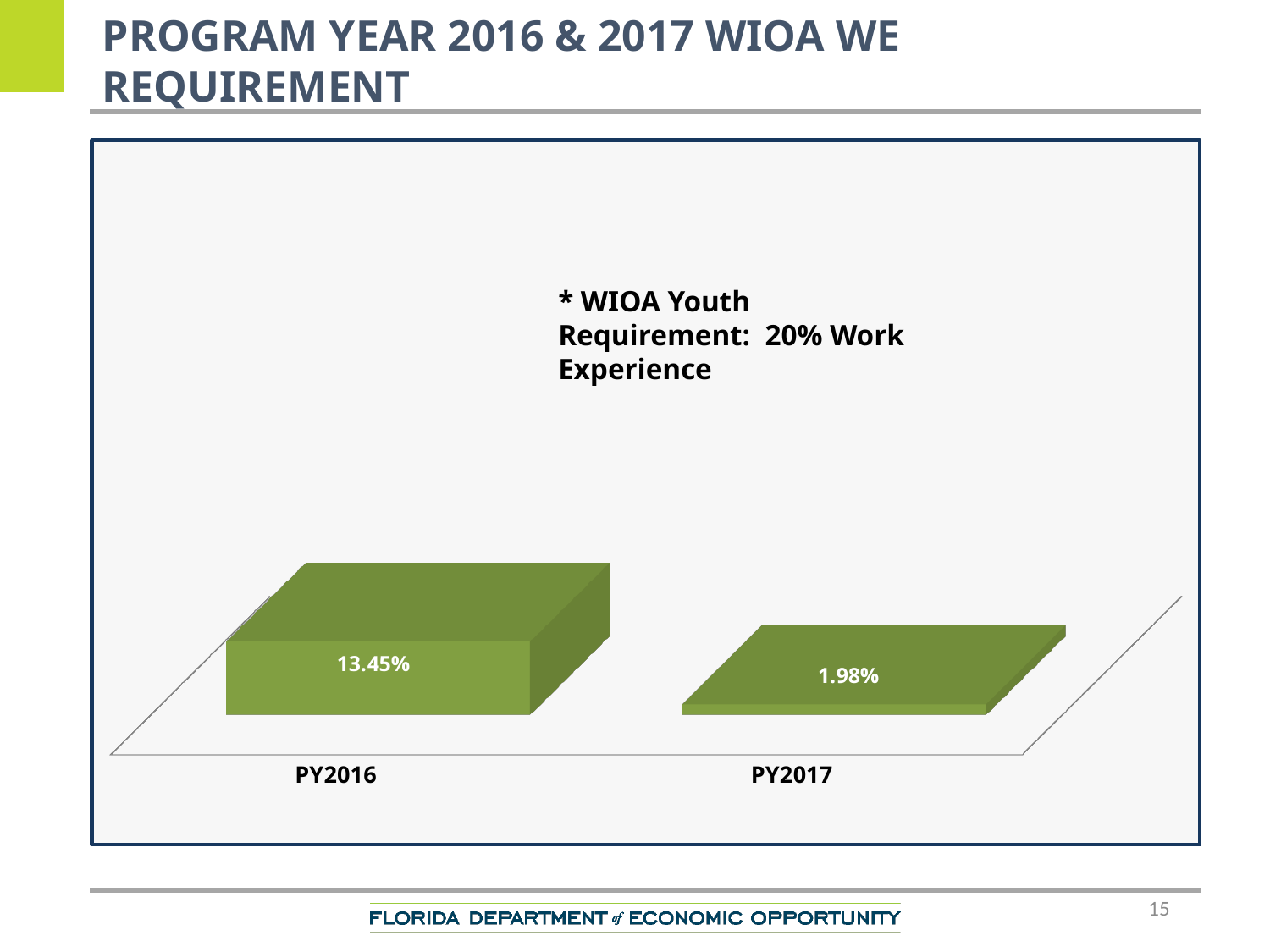
Which is larger, the value for PY2016 or PY2017? PY2016 What is the value for PY2017? 1.98% What is the difference between the PY2016 and PY2017 values? 11.47% What colour are the bars in the chart? Green Which program year has the lowest value? PY2017 Do the values rise or fall from PY2016 to PY2017? Fall What kind of chart is shown on the slide? Bar chart What is the value for PY2016? 13.45% What WIOA Youth Requirement percentage for Work Experience is noted on the chart? 20% Which program year has the highest value? PY2016 How many program years are shown in the chart? 2